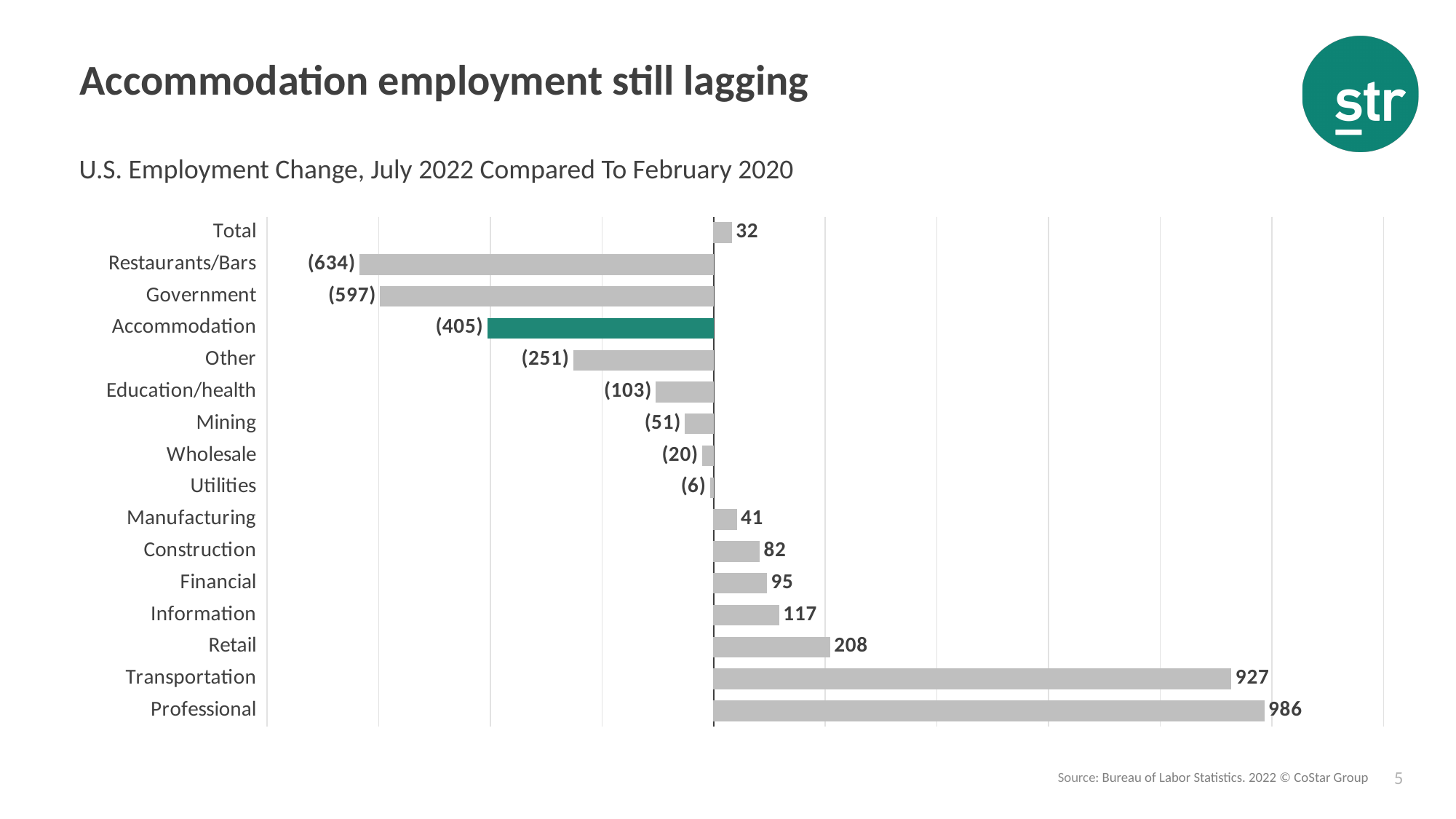
Which category's bar is highlighted in green? Accommodation What is the value shown for Transportation? 927 How many categories are shown in the chart? 16 What is the difference between the values for Professional and Transportation? 59 Which has the larger value, Construction or Financial? Financial What is the value shown for Total? 32 What kind of chart is shown on the slide? Bar chart Which category has the lowest value? Restaurants/Bars What is the difference between the values for Retail and Information? 91 What is the value shown for Accommodation? (405) Which category has the highest value? Professional What is the value shown for Education/health? (103)